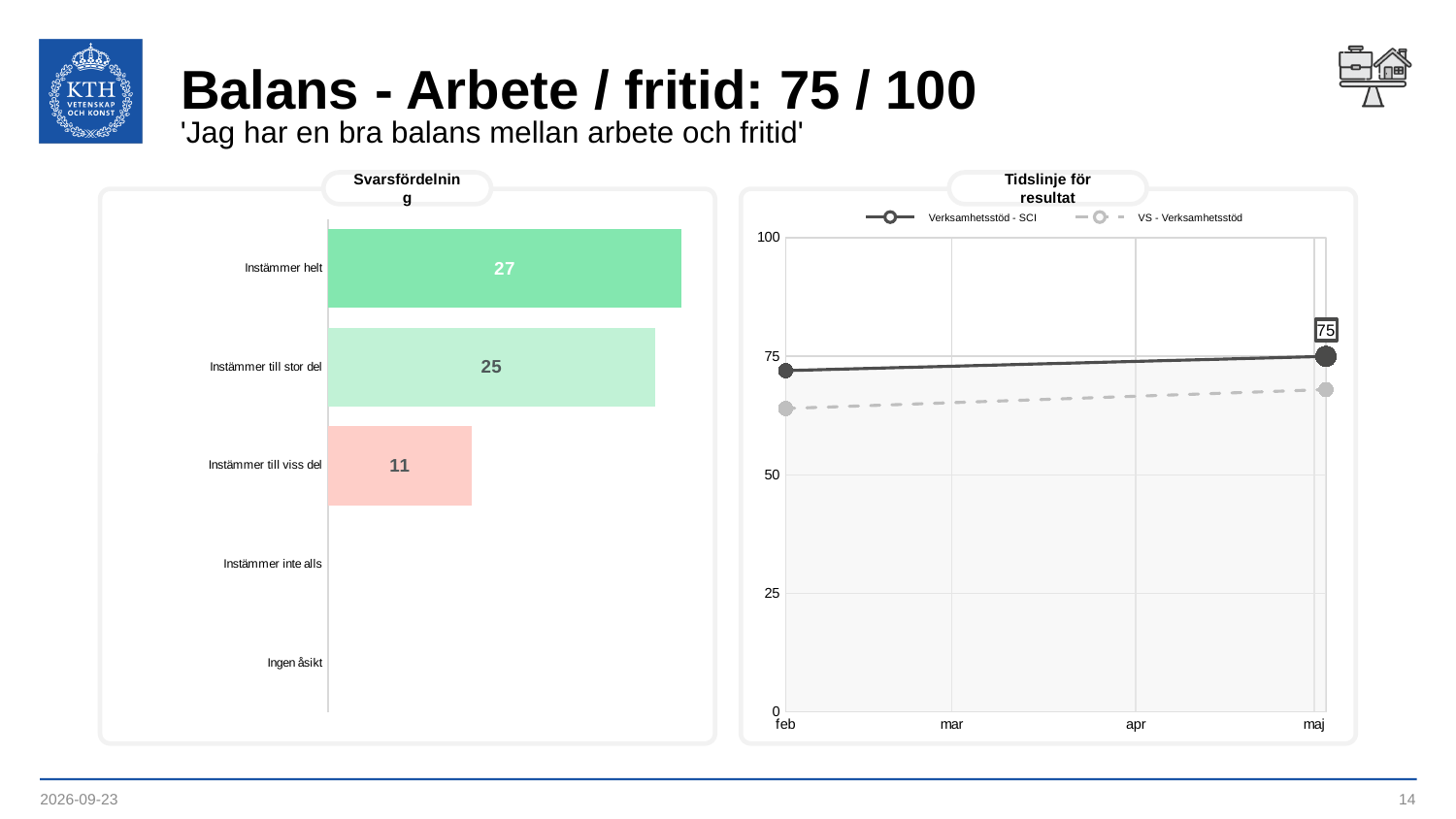
In the 'Svarsfördelning' chart, which is larger: 'Instämmer till stor del' or 'Instämmer till viss del'? Instämmer till stor del In the 'Svarsfördelning' chart, what is the value for 'Instämmer helt'? 27 In the 'Svarsfördelning' chart, what is the difference between 'Instämmer helt' and 'Instämmer till viss del'? 16 How many series does the legend of the 'Tidslinje för resultat' chart list? 2 In the 'Svarsfördelning' chart, which category has the highest value? Instämmer helt In the 'Tidslinje för resultat' chart, what is the value for 'Verksamhetsstöd - SCI' in maj? 75 In the 'Svarsfördelning' chart, what is the value for 'Instämmer till viss del'? 11 How many categories are listed on the axis of the 'Svarsfördelning' chart? 5 What kind of chart is the 'Svarsfördelning' chart? Bar chart In the 'Svarsfördelning' chart, what is the value for 'Instämmer till stor del'? 25 In the 'Tidslinje för resultat' chart, does the 'Verksamhetsstöd - SCI' line rise or fall from feb to maj? rise In the 'Tidslinje för resultat' chart, is the value for 'VS - Verksamhetsstöd' in feb greater or less than 75? less